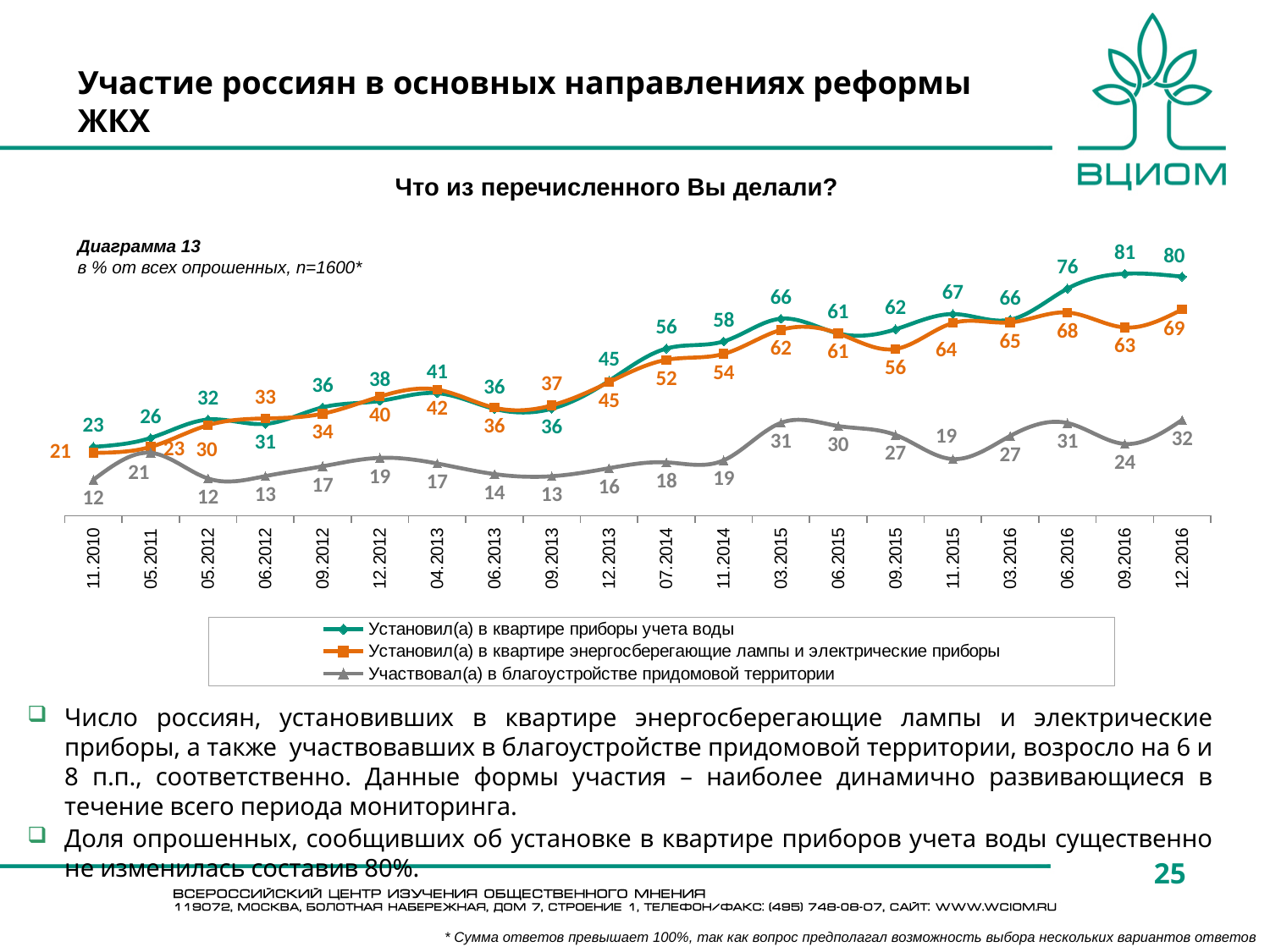
What is the value for 'Установил(а) в квартире энергосберегающие лампы и электрические приборы' in 09.2015? 56 How many series does the legend list? 3 What is the difference between 'Установил(а) в квартире приборы учета воды' and 'Участвовал(а) в благоустройстве придомовой территории' in 12.2016? 48 What is the lowest value shown for 'Участвовал(а) в благоустройстве придомовой территории'? 12 Does the value for 'Установил(а) в квартире приборы учета воды' generally rise or fall from 11.2010 to 12.2016? rise How many time points are shown on the x axis? 20 What is the sample size stated under the chart title 'Диаграмма 13'? n=1600 What is the value for 'Участвовал(а) в благоустройстве придомовой территории' in 03.2015? 31 What type of chart is shown on the slide? line chart At which time point does 'Установил(а) в квартире приборы учета воды' reach its highest value? 09.2016 In 12.2012, which is larger: 'Установил(а) в квартире энергосберегающие лампы и электрические приборы' or 'Установил(а) в квартире приборы учета воды'? Установил(а) в квартире энергосберегающие лампы и электрические приборы What is the value for 'Установил(а) в квартире приборы учета воды' in 12.2016? 80